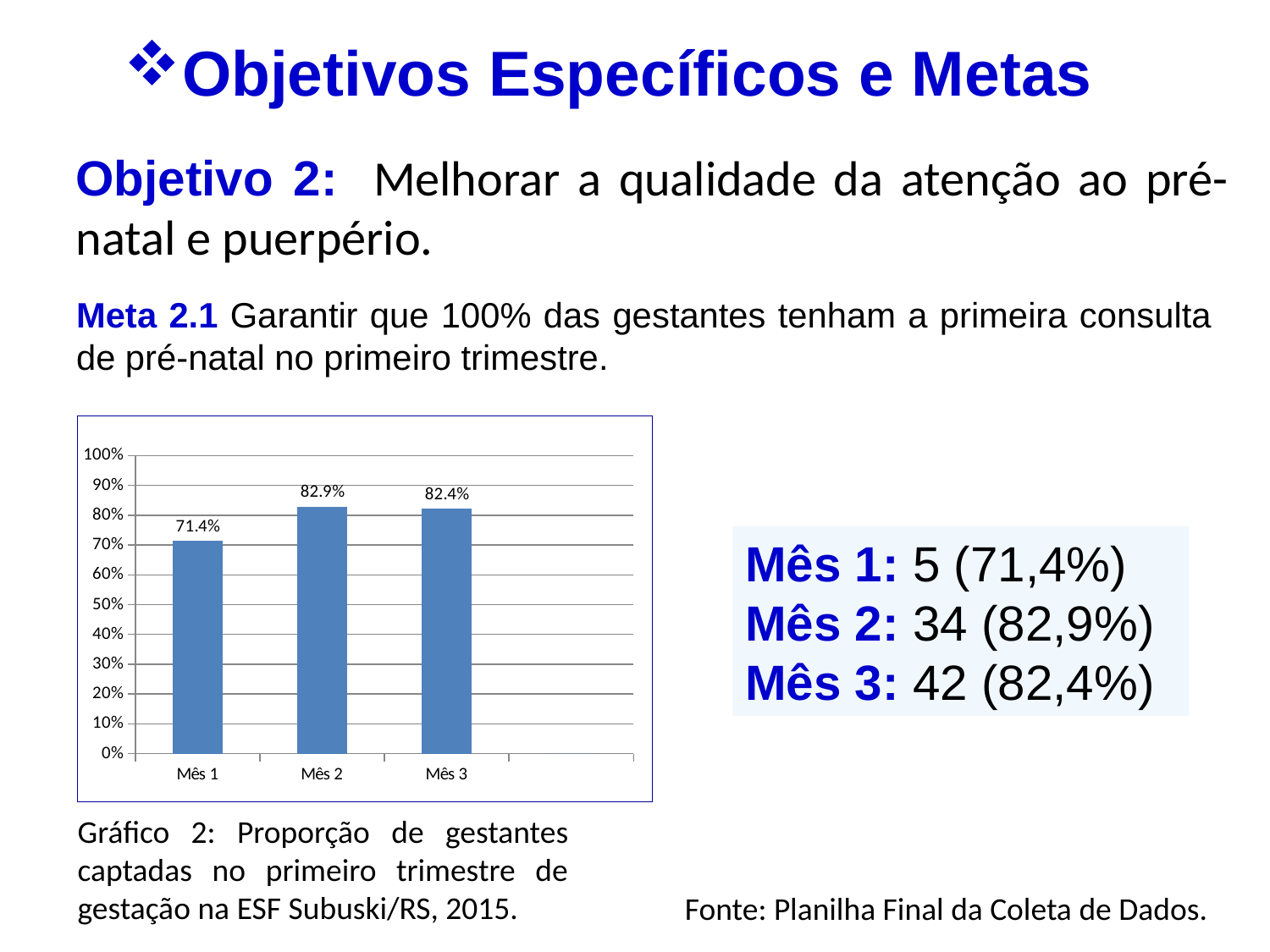
Which month has the highest value? Mês 2 What is the value for Mês 2? 82.9% What is the difference between the values for Mês 2 and Mês 1? 11.5% What is the value for Mês 3? 82.4% Which is larger, the value for Mês 1 or the value for Mês 3? Mês 3 Does the value rise or fall from Mês 1 to Mês 2? rise What kind of chart is shown on the slide? bar chart Which month has the lowest value? Mês 1 How many categories are shown on the x axis? 3 What is the value for Mês 1? 71.4% What is the difference between the values for Mês 2 and Mês 3? 0.5% Is the value for Mês 1 greater or less than 80%? less